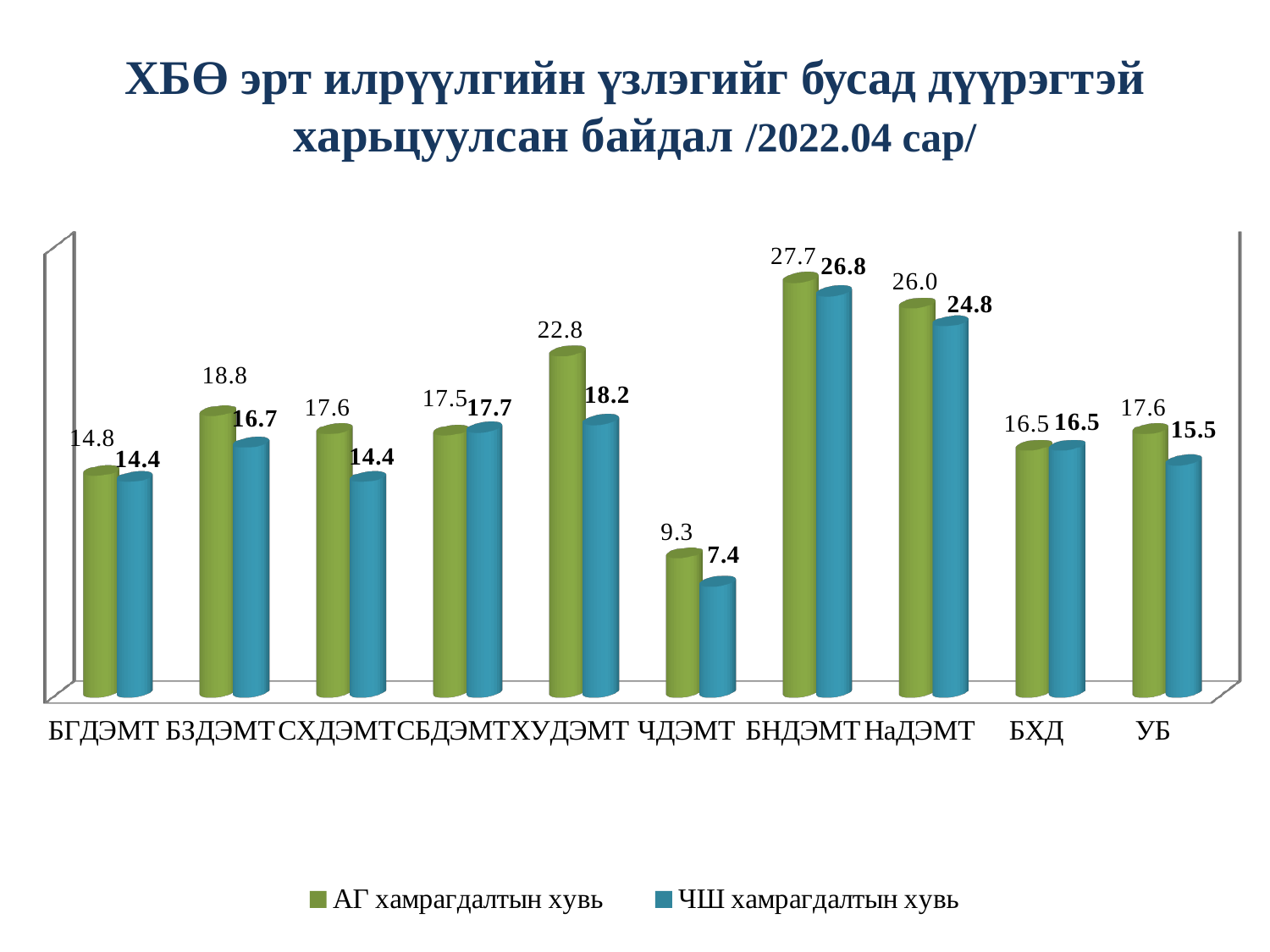
Which is larger for СХДЭМТ: the АГ хамрагдалтын хувь value or the ЧШ хамрагдалтын хувь value? АГ хамрагдалтын хувь What is the ЧШ хамрагдалтын хувь value for ЧДЭМТ? 7.4 Which series is shown in green? АГ хамрагдалтын хувь How many series does the legend list? 2 What is the ЧШ хамрагдалтын хувь value for НаДЭМТ? 24.8 What is the difference between the АГ хамрагдалтын хувь values for БНДЭМТ and НаДЭМТ? 1.7 What kind of chart is shown on the slide? Bar chart What is the АГ хамрагдалтын хувь value for ХУДЭМТ? 22.8 What is the difference between the АГ хамрагдалтын хувь and ЧШ хамрагдалтын хувь values for ХУДЭМТ? 4.6 How many categories are shown on the x axis? 10 Which category has the highest АГ хамрагдалтын хувь value? БНДЭМТ Which category has the lowest ЧШ хамрагдалтын хувь value? ЧДЭМТ